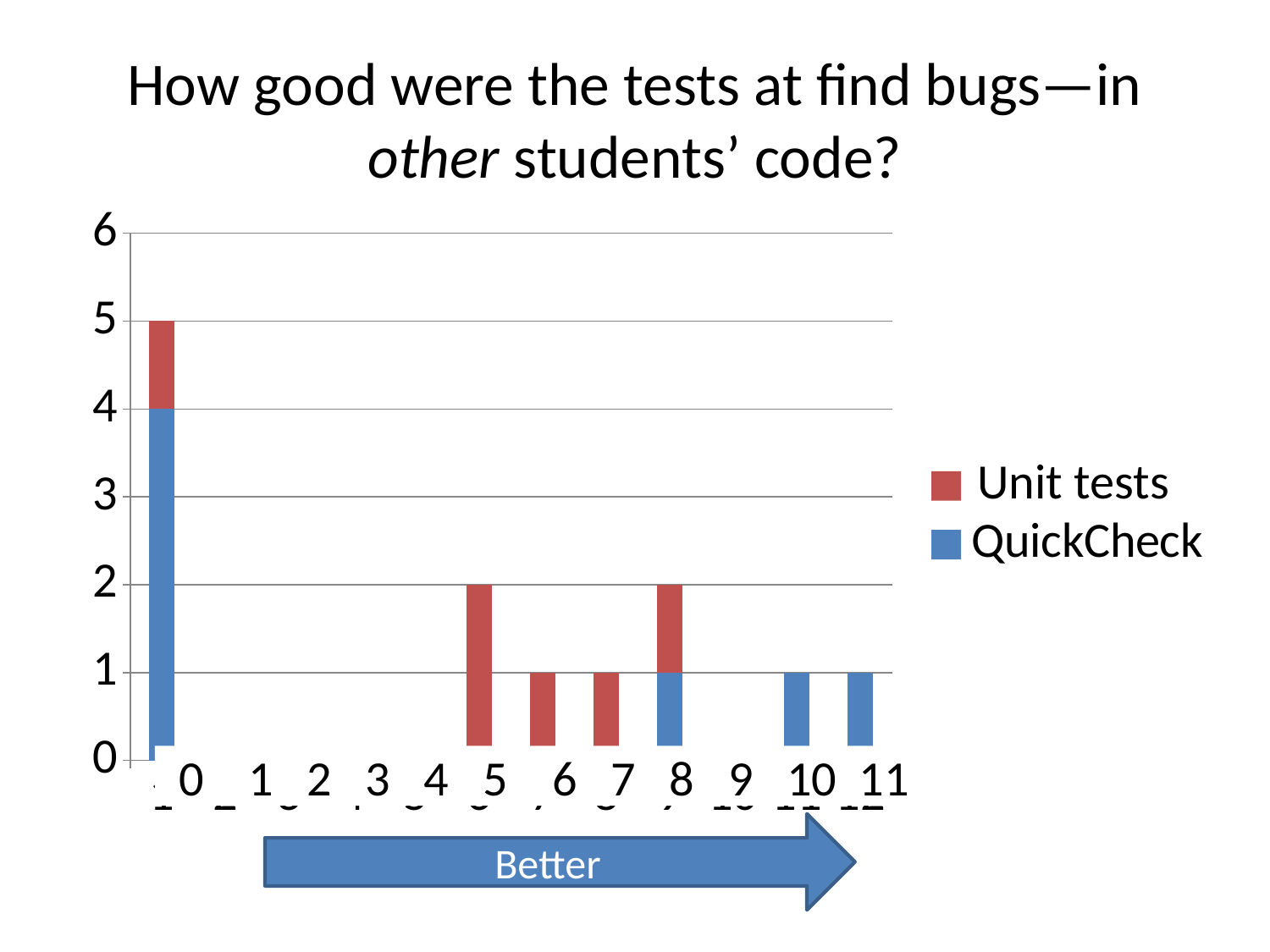
Which category has the tallest bar? 0 What is the QuickCheck value in the leftmost bar (labelled 0)? 4 What is the total height of the stacked bar at category 8? 2 What is the total height of the leftmost bar (labelled 0)? 5 What are the two series named in the legend? Unit tests and QuickCheck Which bar is taller, the one at category 5 or the one at category 6? 5 What is the QuickCheck value for category 10? 1 What is the Unit tests value for category 5? 2 How many series does the legend list? 2 Is the total value of the leftmost bar (labelled 0) greater or less than 3? greater What word is written on the arrow below the x axis? Better What kind of chart is shown on the slide? bar chart